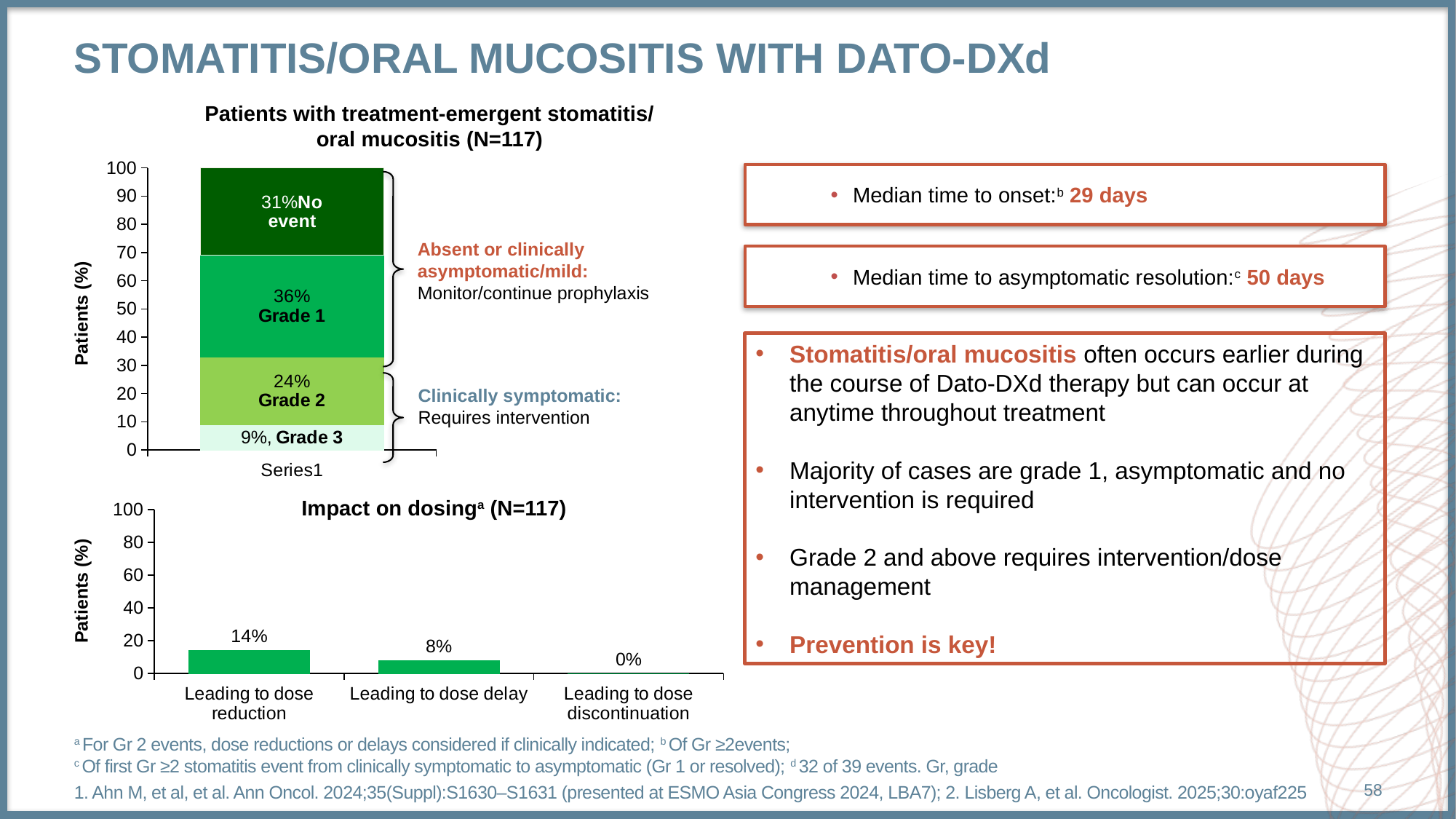
In the 'Patients with treatment-emergent stomatitis/oral mucositis' chart, what percentage of patients had Grade 1 stomatitis? 36% In the 'Impact on dosing' chart, what percentage of patients had stomatitis leading to dose reduction? 14% In the 'Impact on dosing' chart, what percentage of patients had stomatitis leading to dose discontinuation? 0% In the 'Impact on dosing' chart, what percentage of patients had stomatitis leading to dose delay? 8% In the 'Patients with treatment-emergent stomatitis/oral mucositis' chart, what percentage of patients had no event? 31% In the 'Patients with treatment-emergent stomatitis/oral mucositis' chart, what is the difference between the Grade 1 and Grade 2 percentages? 12% In the 'Patients with treatment-emergent stomatitis/oral mucositis' chart, which segment has the largest percentage? Grade 1 In the 'Patients with treatment-emergent stomatitis/oral mucositis' chart, what is the total of the Grade 2 and Grade 3 segments? 33% In the 'Impact on dosing' chart, how many categories are shown on the x axis? 3 In the 'Patients with treatment-emergent stomatitis/oral mucositis' chart, which segment has the smallest percentage? Grade 3 In the 'Patients with treatment-emergent stomatitis/oral mucositis' chart, what percentage of patients had Grade 3 stomatitis? 9% What type of chart is the 'Impact on dosing' chart? Bar chart